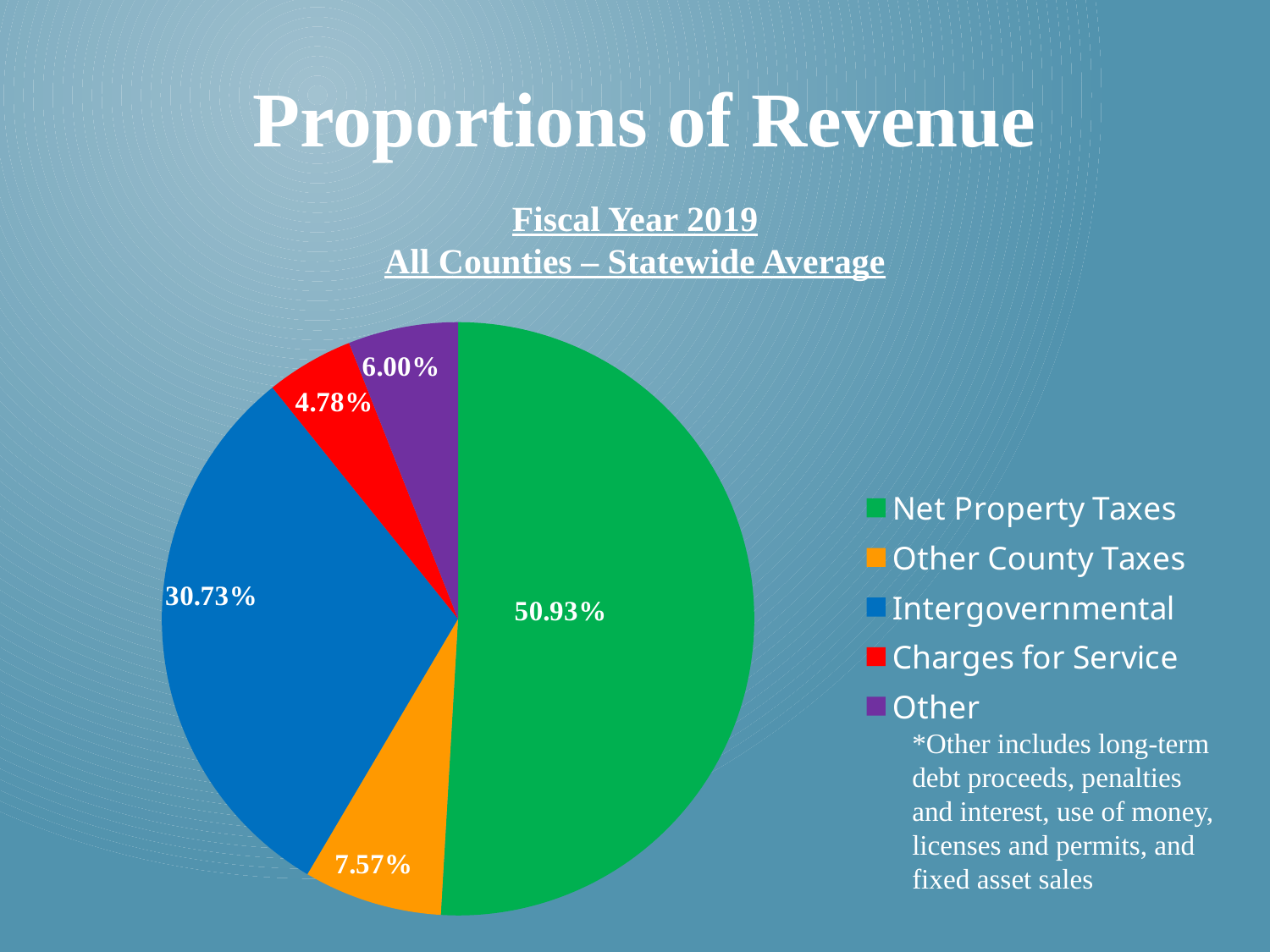
Which is larger, the share for Other County Taxes or the share for Other? Other County Taxes What share of revenue comes from Net Property Taxes? 50.93% Which colour represents Intergovernmental in the pie chart? Blue What share of revenue comes from Other County Taxes? 7.57% What kind of chart is shown on the slide? Pie chart Which revenue category has the largest share of the pie? Net Property Taxes Which revenue category has the smallest share of the pie? Charges for Service What share of revenue comes from Intergovernmental sources? 30.73% What share of revenue comes from Charges for Service? 4.78% What share of revenue is labelled Other? 6.00% What is the difference in percentage points between Net Property Taxes and Intergovernmental? 20.20 How many slices does the pie chart have? 5